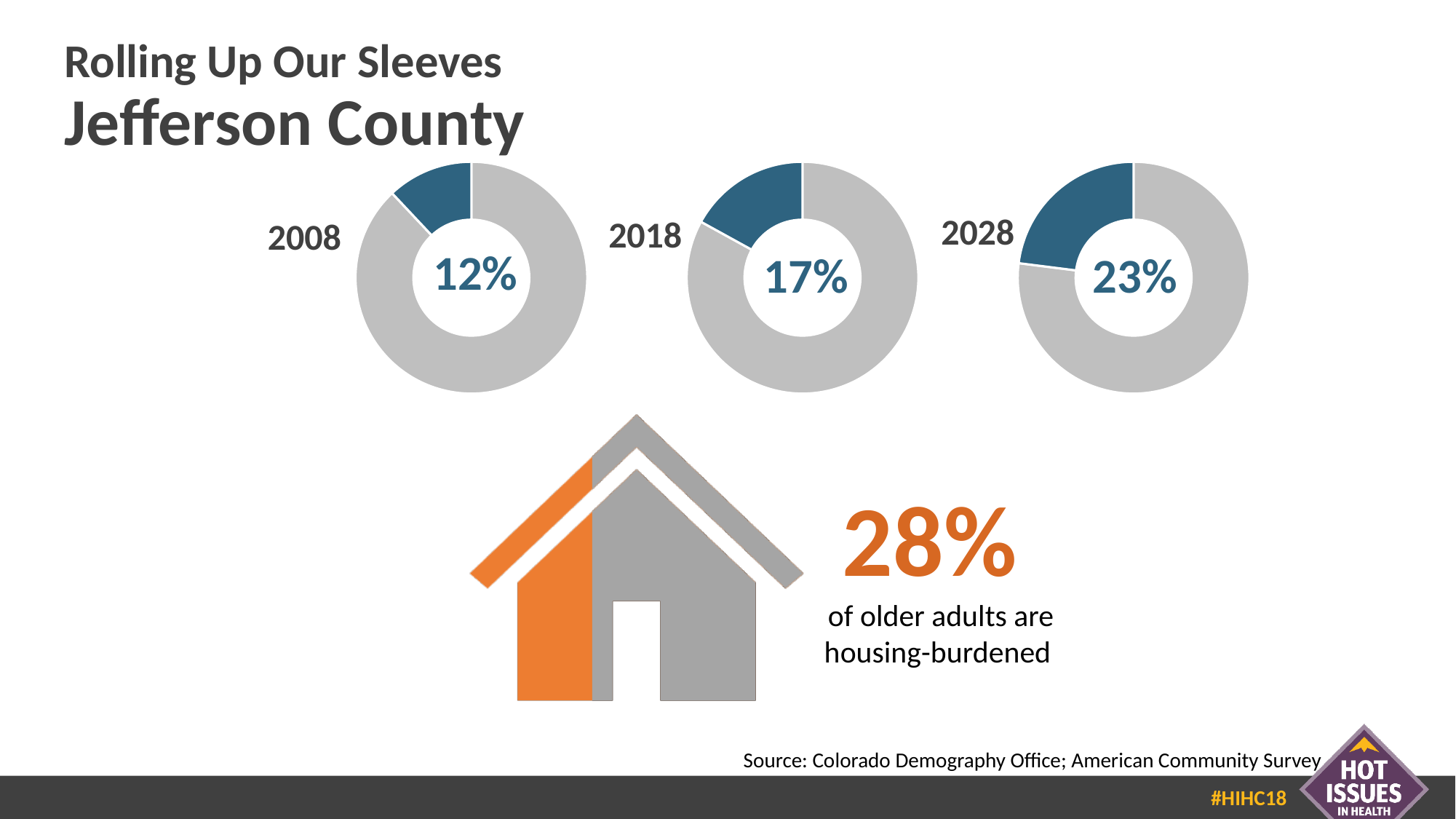
Which year's donut chart shows the highest percentage? 2028 What is the difference in percentage points between the 2018 and 2008 donut charts? 5 Which is larger, the percentage in the 2018 donut chart or the 2028 donut chart? 2028 How many donut charts are shown on the slide? 3 Do the percentages in the donut charts rise or fall from 2008 to 2028? Rise What value is shown in the centre of the 2028 donut chart? 23% What kind of charts are used to show the 2008, 2018 and 2028 values? Donut charts What value is shown in the centre of the 2018 donut chart? 17% What colour is the highlighted segment in each donut chart? Blue Which year's donut chart shows the lowest percentage? 2008 What is the difference in percentage points between the 2028 and 2008 donut charts? 11 What value is shown in the centre of the 2008 donut chart? 12%